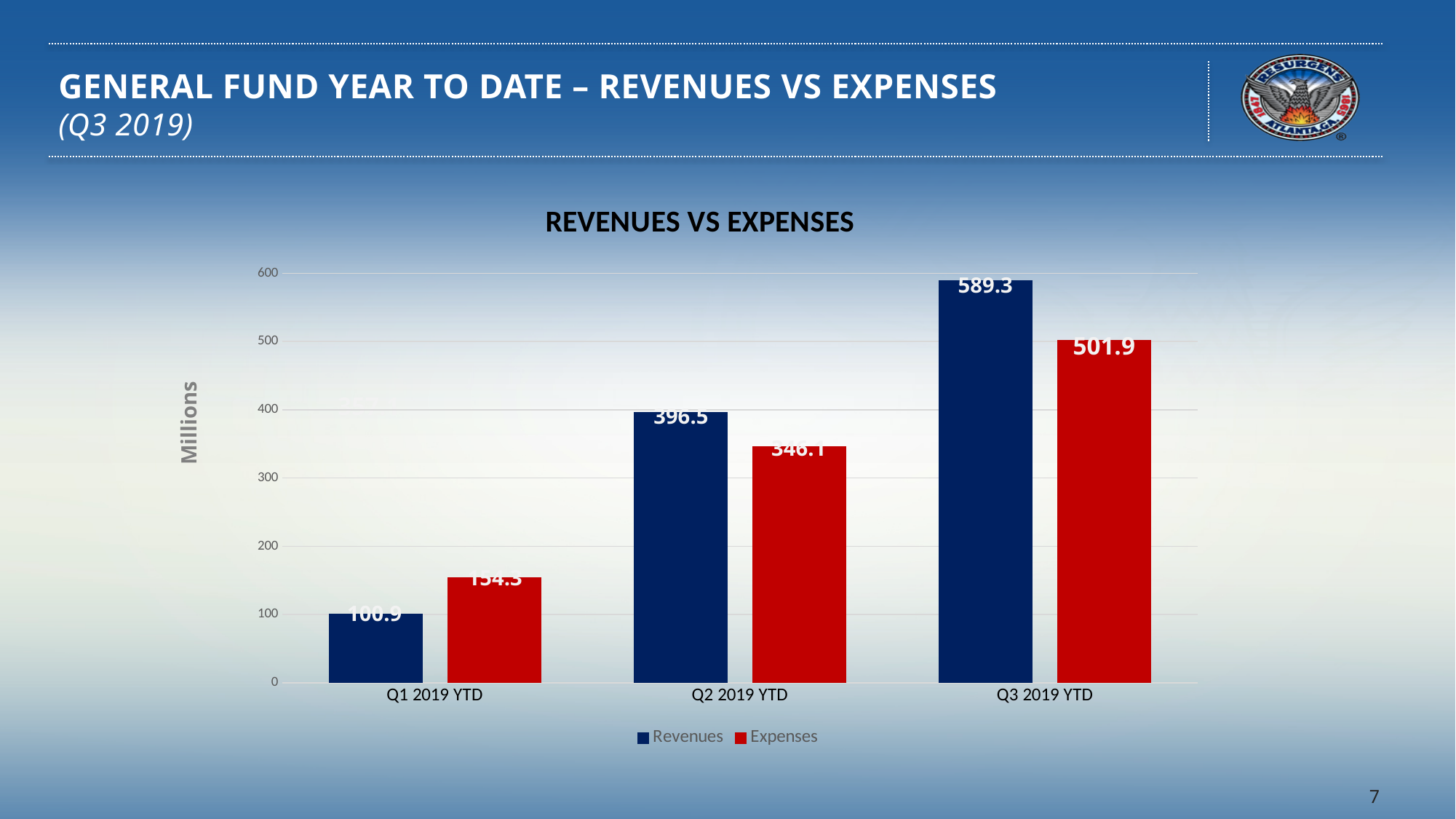
What is the value for Revenues in Q1 2019 YTD? 100.9 Do the Revenues values rise or fall from Q1 2019 YTD to Q3 2019 YTD? rise What is the value for Expenses in Q3 2019 YTD? 501.9 What is the difference between Revenues and Expenses in Q3 2019 YTD? 87.4 What is the value for Revenues in Q3 2019 YTD? 589.3 How many periods are shown on the x axis? 3 In Q1 2019 YTD, which is larger, Revenues or Expenses? Expenses Which period has the highest Revenues value? Q3 2019 YTD Is the value for Expenses in Q1 2019 YTD greater or less than 200? less Which period has the lowest Expenses value? Q1 2019 YTD How many series does the legend list? 2 What is the value for Revenues in Q2 2019 YTD? 396.5